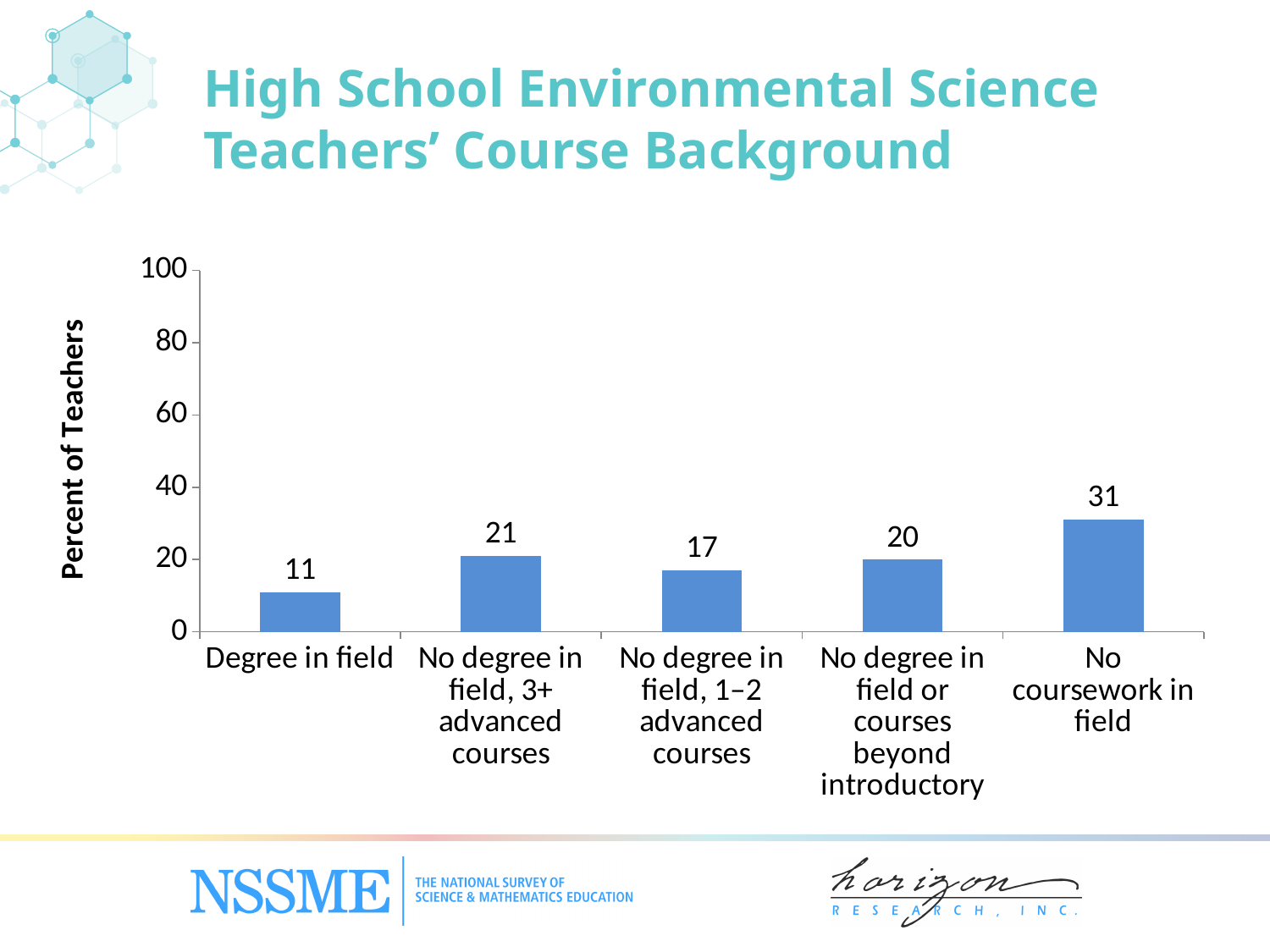
What is the difference between the values for "No coursework in field" and "Degree in field"? 20 Which is larger: the value for "No degree in field, 3+ advanced courses" or "No degree in field, 1–2 advanced courses"? No degree in field, 3+ advanced courses What percent of teachers have no degree in field, 1–2 advanced courses? 17 Which category has the highest percent of teachers? No coursework in field How many categories are shown on the x axis? 5 What is the label of the y axis? Percent of Teachers Which category has the lowest percent of teachers? Degree in field What is the value for "No coursework in field"? 31 What percent of teachers have a degree in field? 11 What kind of chart is shown on the slide? Bar chart Is the value for "No coursework in field" greater or less than 40? less What is the title of the slide? High School Environmental Science Teachers' Course Background